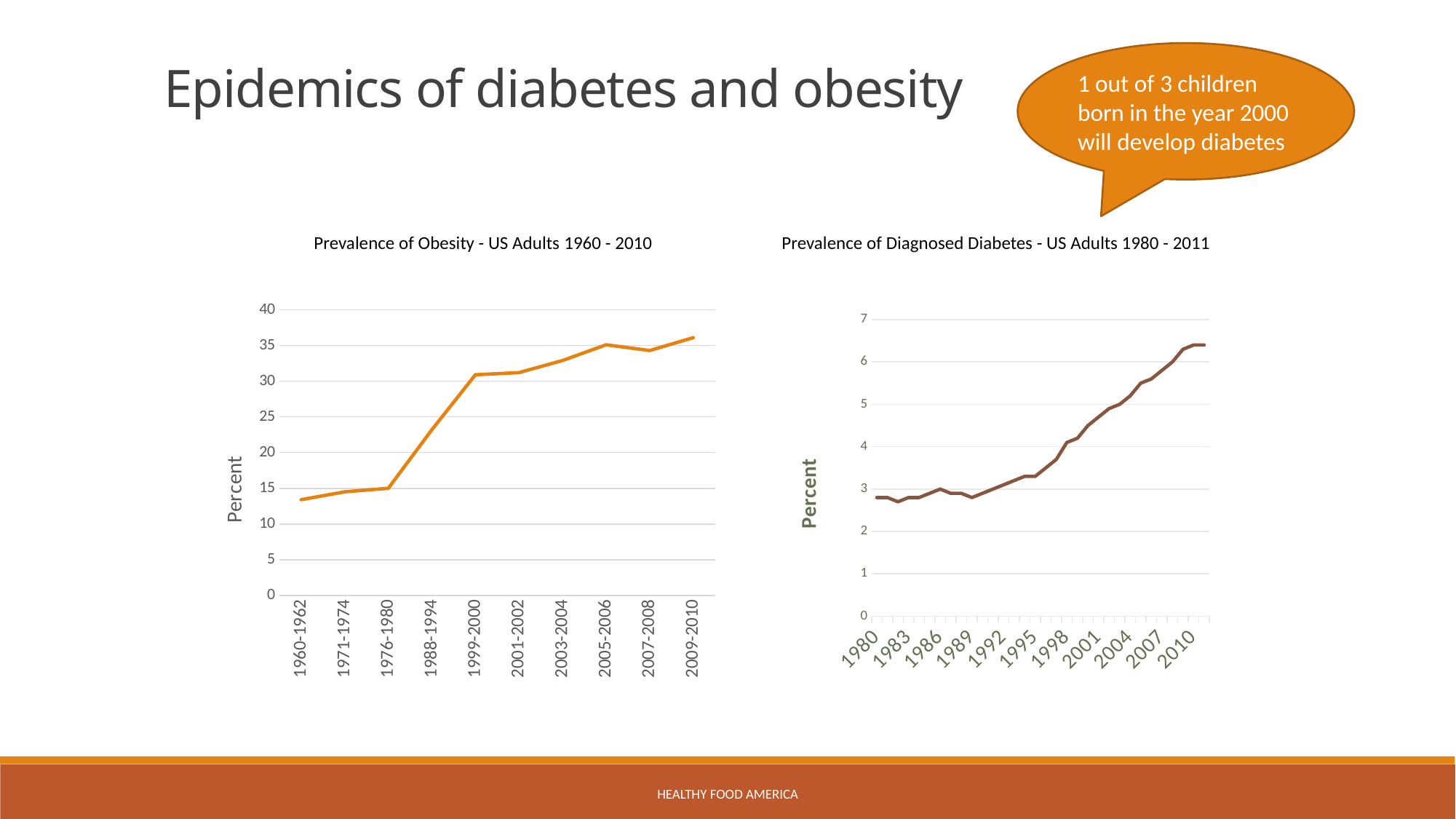
On the 'Prevalence of Obesity - US Adults 1960 - 2010' chart, which is larger, the value for 1976-1980 or the value for 1999-2000? 1999-2000 On the 'Prevalence of Diagnosed Diabetes - US Adults 1980 - 2011' chart, is the value for 2010 greater or less than 6? greater On the 'Prevalence of Obesity - US Adults 1960 - 2010' chart, is the value for 1999-2000 greater or less than 30? greater How many data points are plotted on the 'Prevalence of Obesity - US Adults 1960 - 2010' chart? 10 What kind of chart is the 'Prevalence of Obesity - US Adults 1960 - 2010' chart? line chart On the 'Prevalence of Obesity - US Adults 1960 - 2010' chart, is the value for 2009-2010 greater or less than 35? greater On the 'Prevalence of Obesity - US Adults 1960 - 2010' chart, do the values generally rise or fall from 1960-1962 to 2009-2010? rise On the 'Prevalence of Diagnosed Diabetes - US Adults 1980 - 2011' chart, do the values rise or fall from 1995 to 2010? rise What is the label on the vertical axis of the 'Prevalence of Diagnosed Diabetes - US Adults 1980 - 2011' chart? Percent On the 'Prevalence of Obesity - US Adults 1960 - 2010' chart, which period has the lowest value? 1960-1962